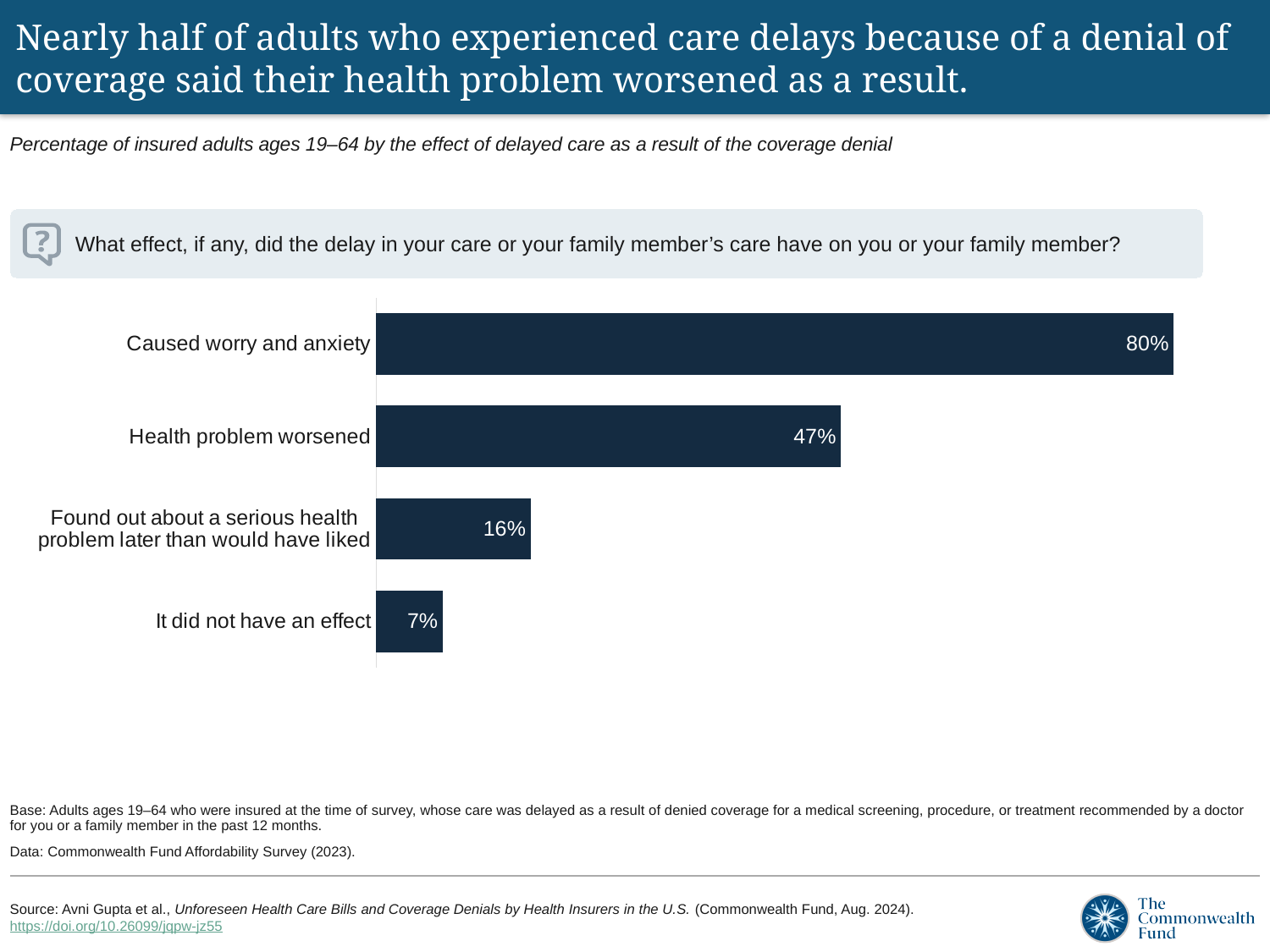
Which effect of delayed care has the highest percentage? Caused worry and anxiety What survey question is the chart based on? What effect, if any, did the delay in your care or your family member's care have on you or your family member? What is the difference in percentage points between 'Found out about a serious health problem later than would have liked' and 'It did not have an effect'? 9 percentage points Which category has the lowest percentage? It did not have an effect What percentage of adults said the delay did not have an effect? 7% Which is larger: the percentage for 'Health problem worsened' or for 'Found out about a serious health problem later than would have liked'? Health problem worsened What is the difference in percentage points between 'Caused worry and anxiety' and 'Health problem worsened'? 33 percentage points How many categories are shown in the chart? 4 What percentage of adults said their health problem worsened as a result of the delay? 47% What kind of chart is shown on the slide? Bar chart What percentage of adults said the delay in care caused worry and anxiety? 80% What percentage of adults found out about a serious health problem later than they would have liked? 16%